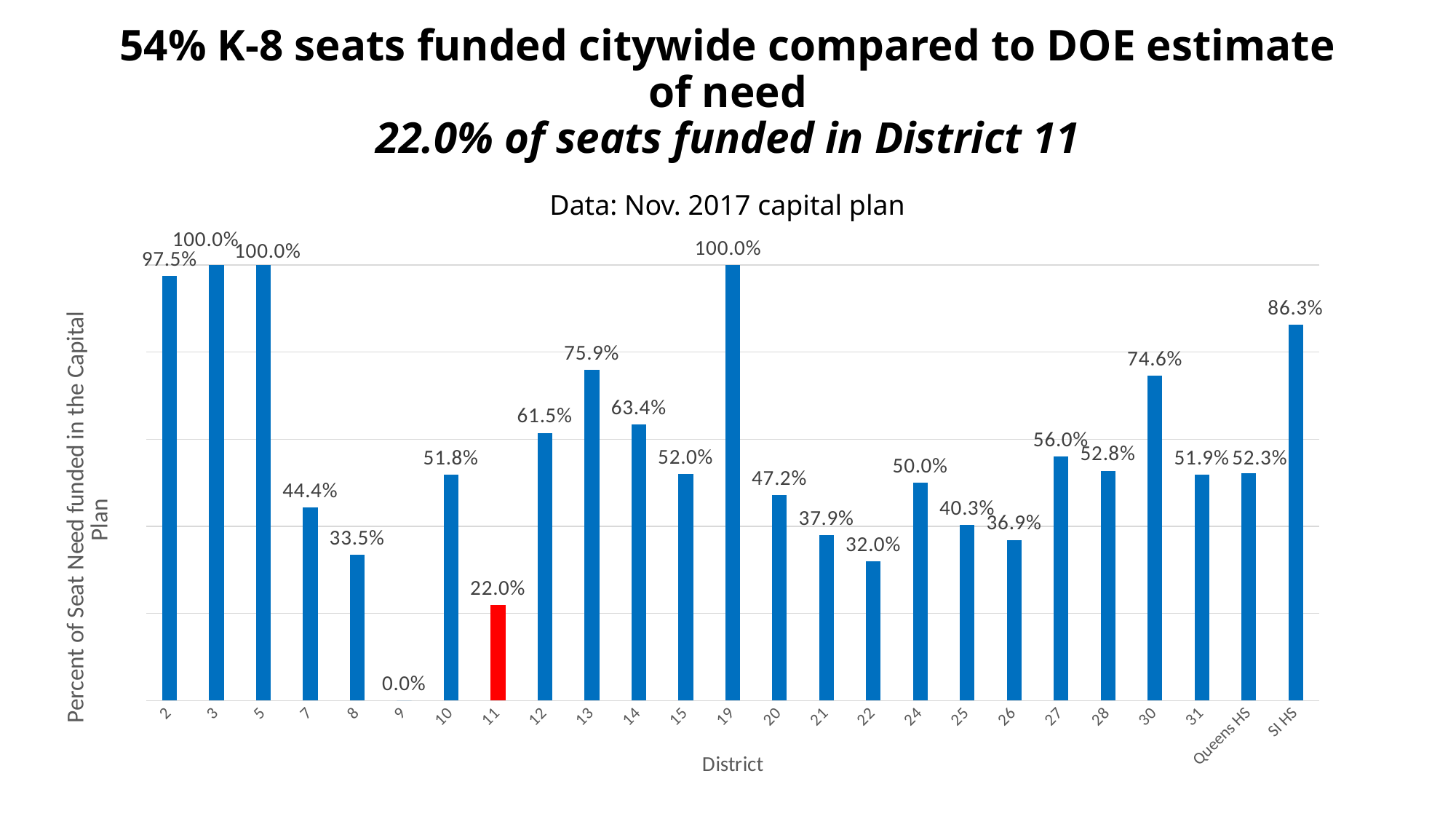
What is the value for District 13? 75.9% How many categories are shown on the x axis? 25 What is the value for District 11? 22.0% What is the value for SI HS? 86.3% What is the value for Queens HS? 52.3% Which has the larger value, District 12 or District 14? District 14 Which has the larger value, District 27 or District 28? District 27 Which district's bar is coloured red? 11 What is the difference between the values for SI HS and Queens HS? 34.0 percentage points What kind of chart is shown on the slide? Bar chart What is the difference between the values for District 13 and District 11? 53.9 percentage points Which district has the lowest percent of seat need funded? 9